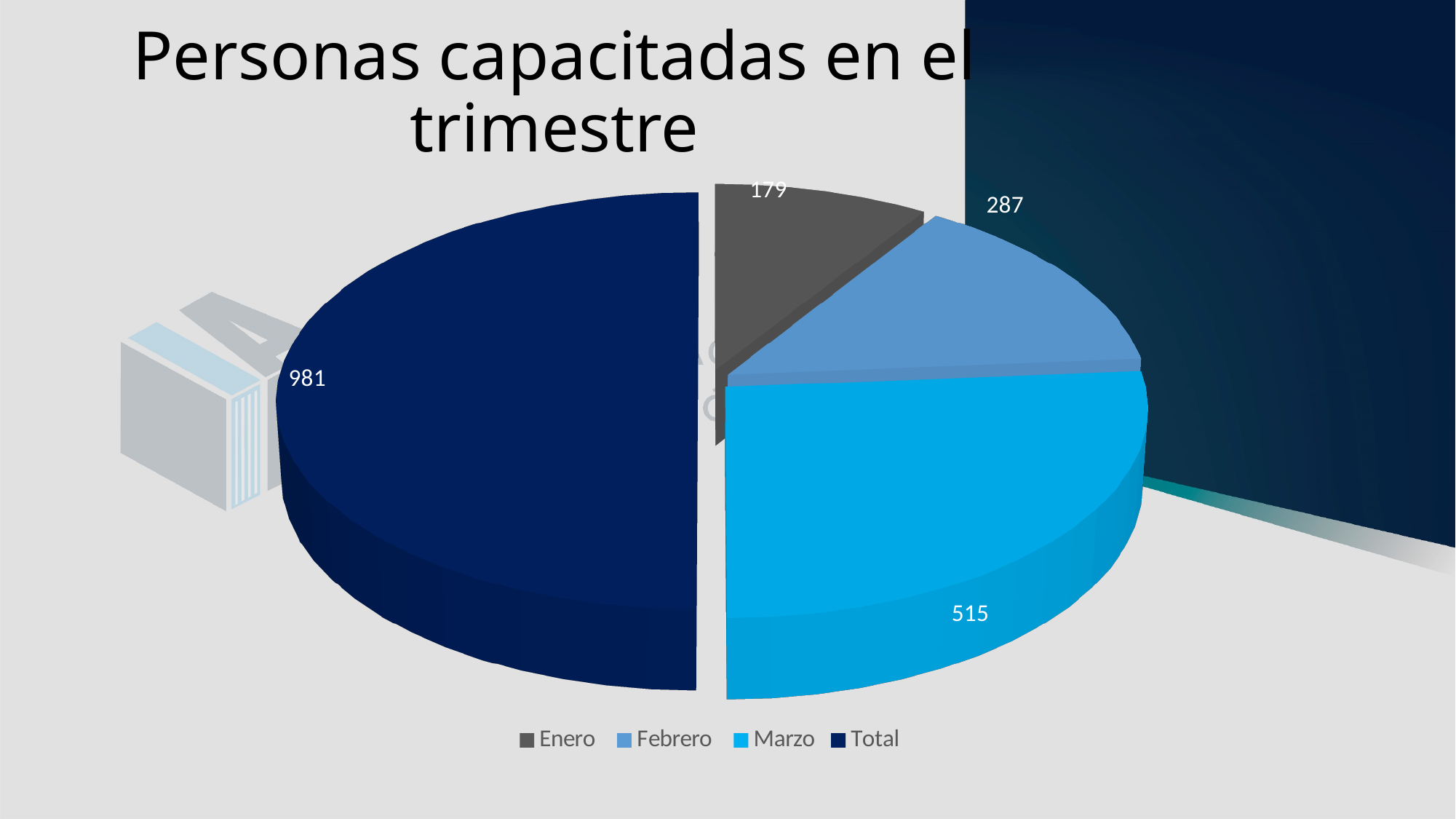
How many slices does the pie chart have? 4 Which is larger, the value for Marzo or the value for Febrero? Marzo What is the difference between the values for Febrero and Enero? 108 What is the value shown for Marzo? 515 What is the title of the chart? Personas capacitadas en el trimestre Which slice has the largest value? Total What is the value shown for Enero? 179 What is the value shown for Febrero? 287 Which slice has the smallest value? Enero What kind of chart is shown on the slide? Pie chart What is the difference between the values for Marzo and Febrero? 228 What is the value shown for the Total slice? 981